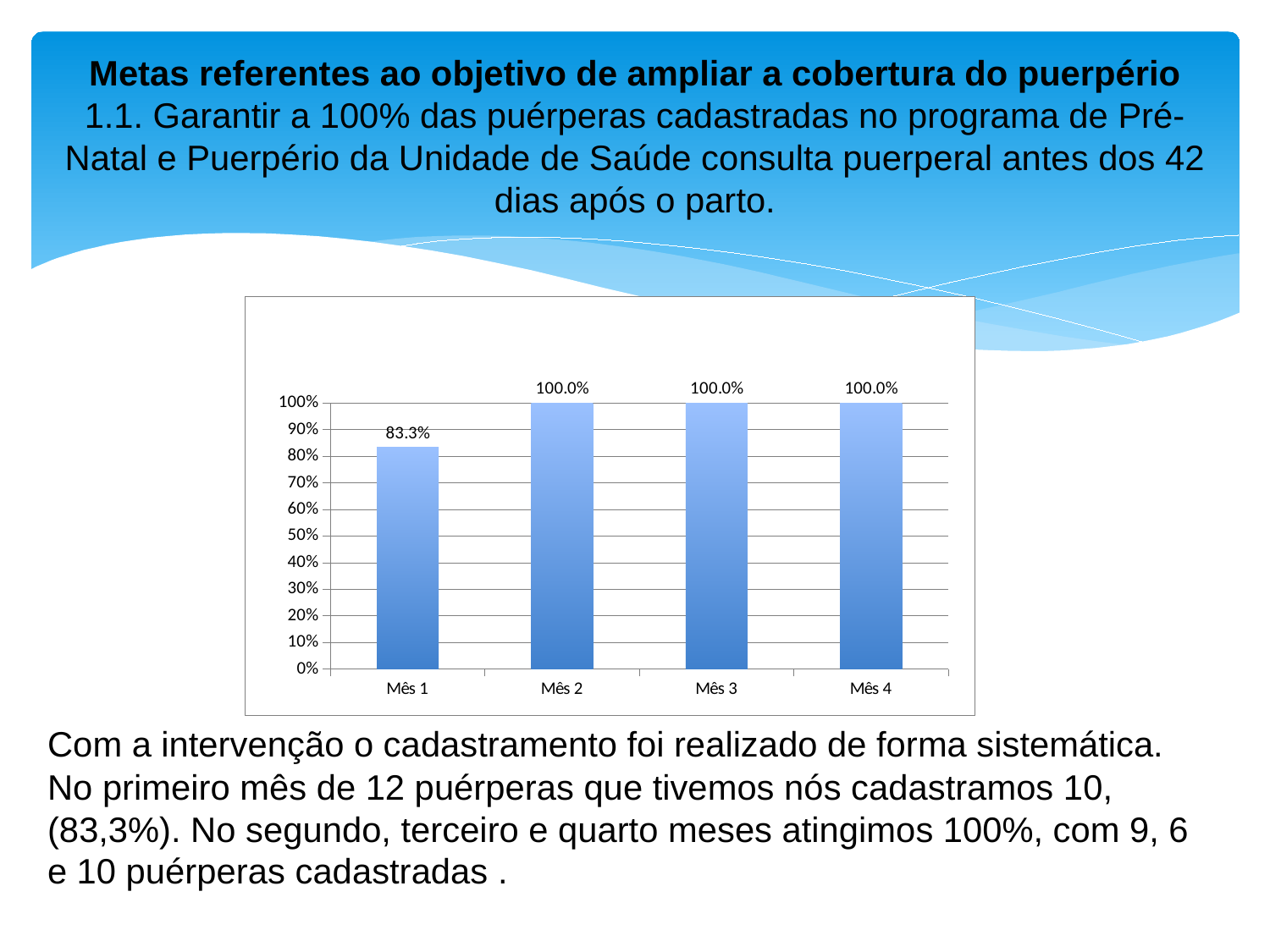
Which month has the lowest value? Mês 1 Is the value for Mês 1 greater or less than 90%? less How many months have a value of 100.0%? 3 What is the value for Mês 4? 100.0% What is the difference between the values for Mês 2 and Mês 1? 16.7% How many categories are shown on the x axis? 4 What kind of chart is shown on the slide? bar chart Which is larger, the value for Mês 1 or the value for Mês 3? Mês 3 What is the highest value shown on the y axis? 100% What is the value for Mês 2? 100.0% What is the value for Mês 1? 83.3% Do the values rise or fall from Mês 1 to Mês 2? rise